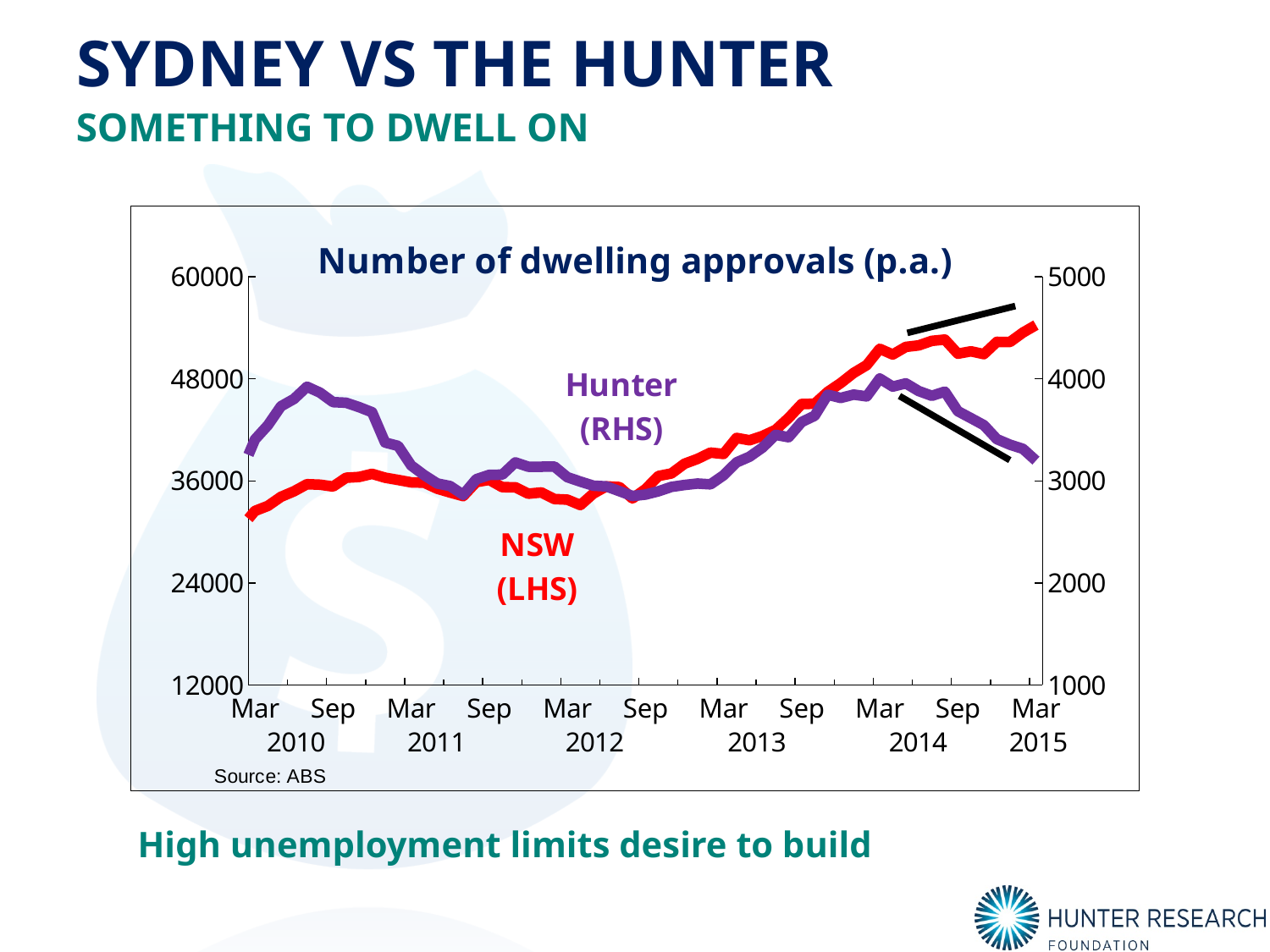
Is the value for NSW at Mar 2014 greater or less than 48000? greater Does the NSW series rise or fall between Mar 2013 and Mar 2015? rise What kind of chart is shown on the slide? Line chart Which series is plotted against the right-hand axis (RHS)? Hunter Is the value for Hunter at Mar 2015 greater or less than 4000? less Is the value for NSW at Mar 2015 greater or less than 48000? greater Does the Hunter series rise or fall between Sep 2010 and Mar 2012? fall What is the title of the chart? Number of dwelling approvals (p.a.) Does the Hunter series rise or fall between Mar 2014 and Mar 2015? fall How many series are plotted on the chart? 2